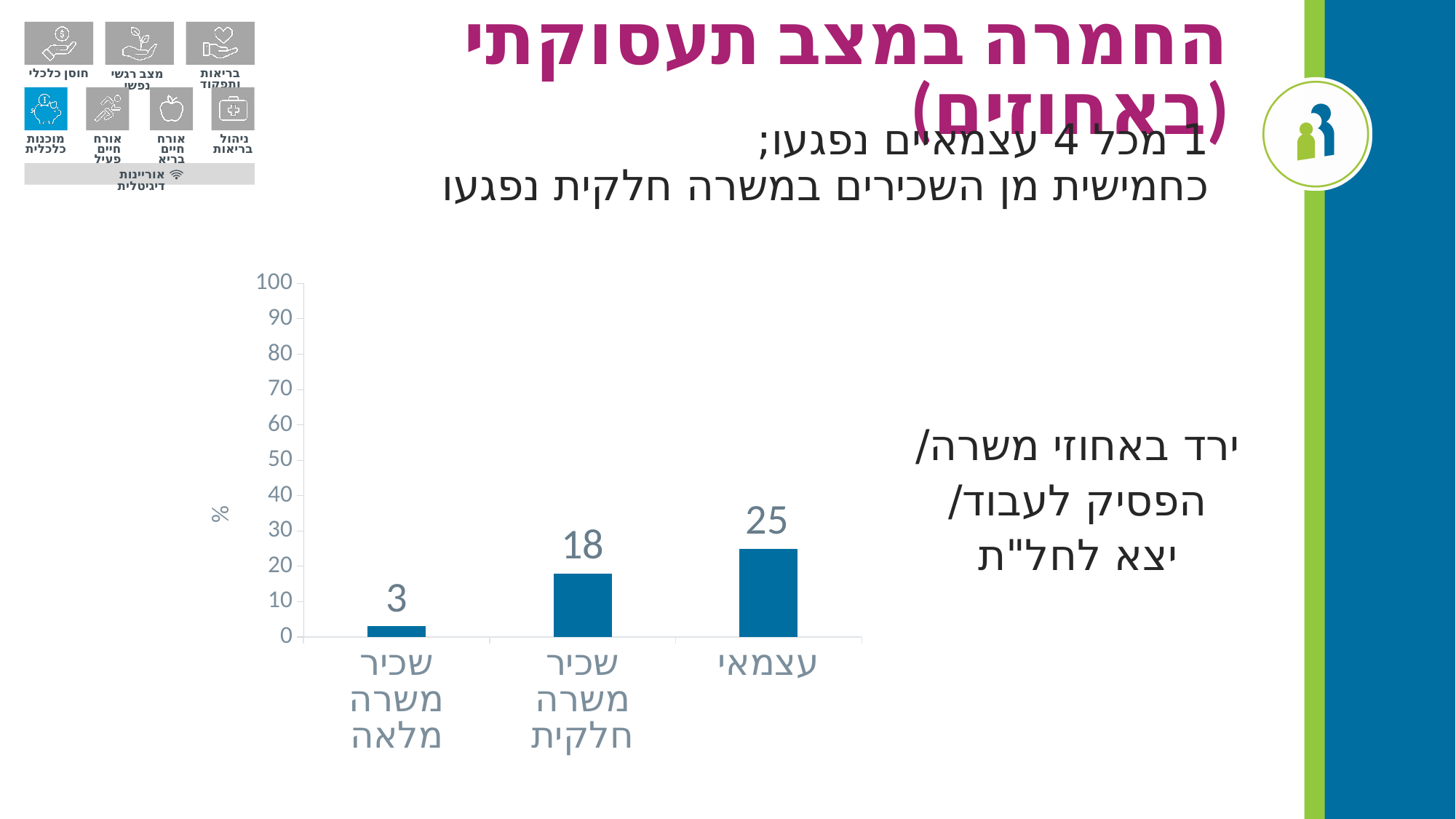
What is the label on the vertical axis of the chart? % What is the value for שכיר משרה מלאה? 3 What is the difference between the values for שכיר משרה חלקית and שכיר משרה מלאה? 15 Is the value for עצמאי greater or less than 20? greater What is the value for שכיר משרה חלקית? 18 What is the value for עצמאי? 25 What is the difference between the values for עצמאי and שכיר משרה חלקית? 7 Which is larger, the value for עצמאי or the value for שכיר משרה מלאה? עצמאי What kind of chart is shown on the slide? bar chart Which category has the highest value? עצמאי Which category has the lowest value? שכיר משרה מלאה How many categories are shown on the x axis? 3